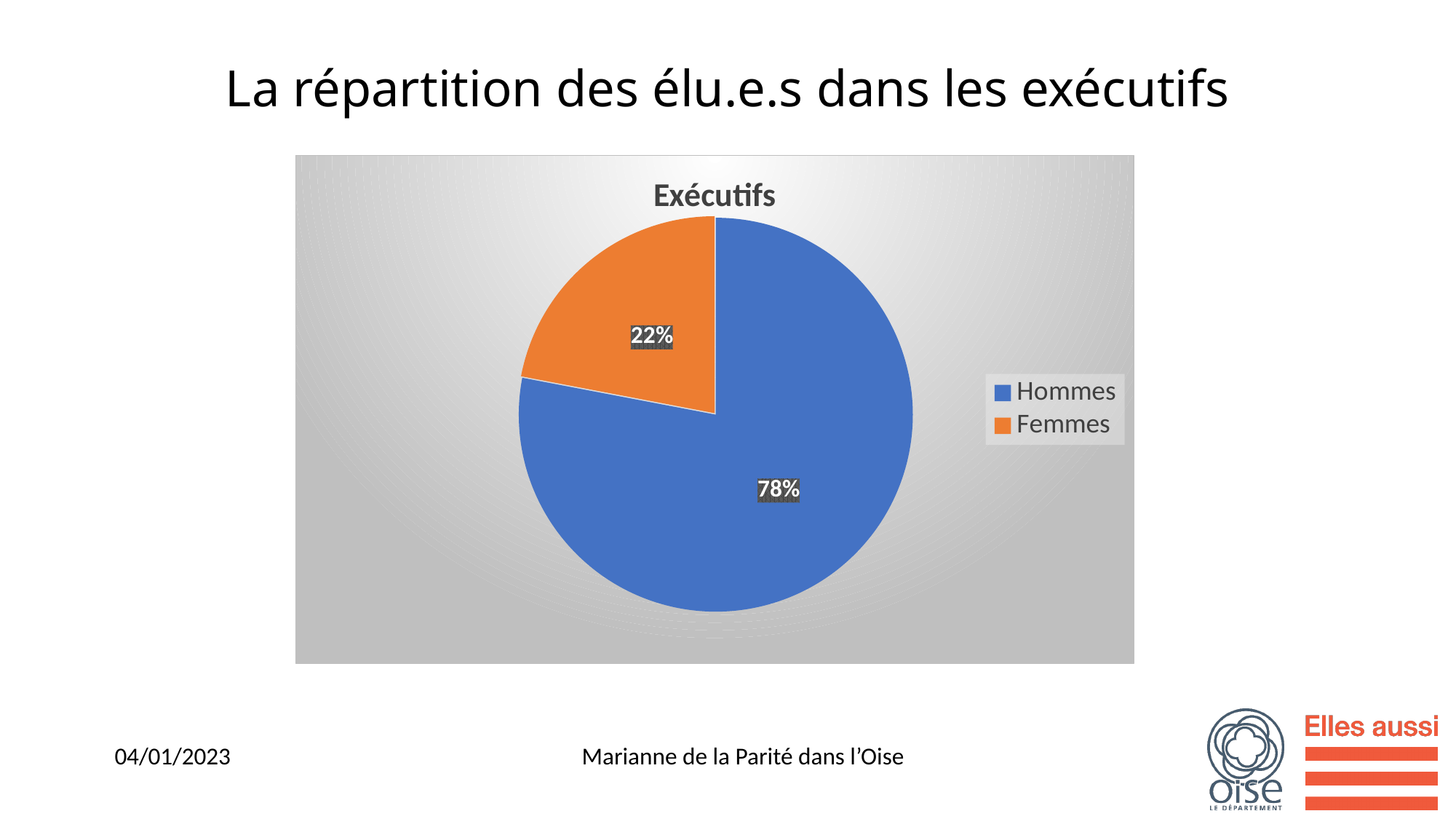
How many categories are shown in the pie chart? 2 How many entries does the legend list? 2 What is the title of the chart? Exécutifs What kind of chart is shown on the slide? Pie chart Which slice is larger, Hommes or Femmes? Hommes What is the difference in percentage points between the Hommes and Femmes slices? 56 Which category has the smallest slice of the pie? Femmes What share of the pie does Hommes represent? 78% What share of the pie does Femmes represent? 22% What colour is the Femmes slice? Orange Which category has the largest slice of the pie? Hommes